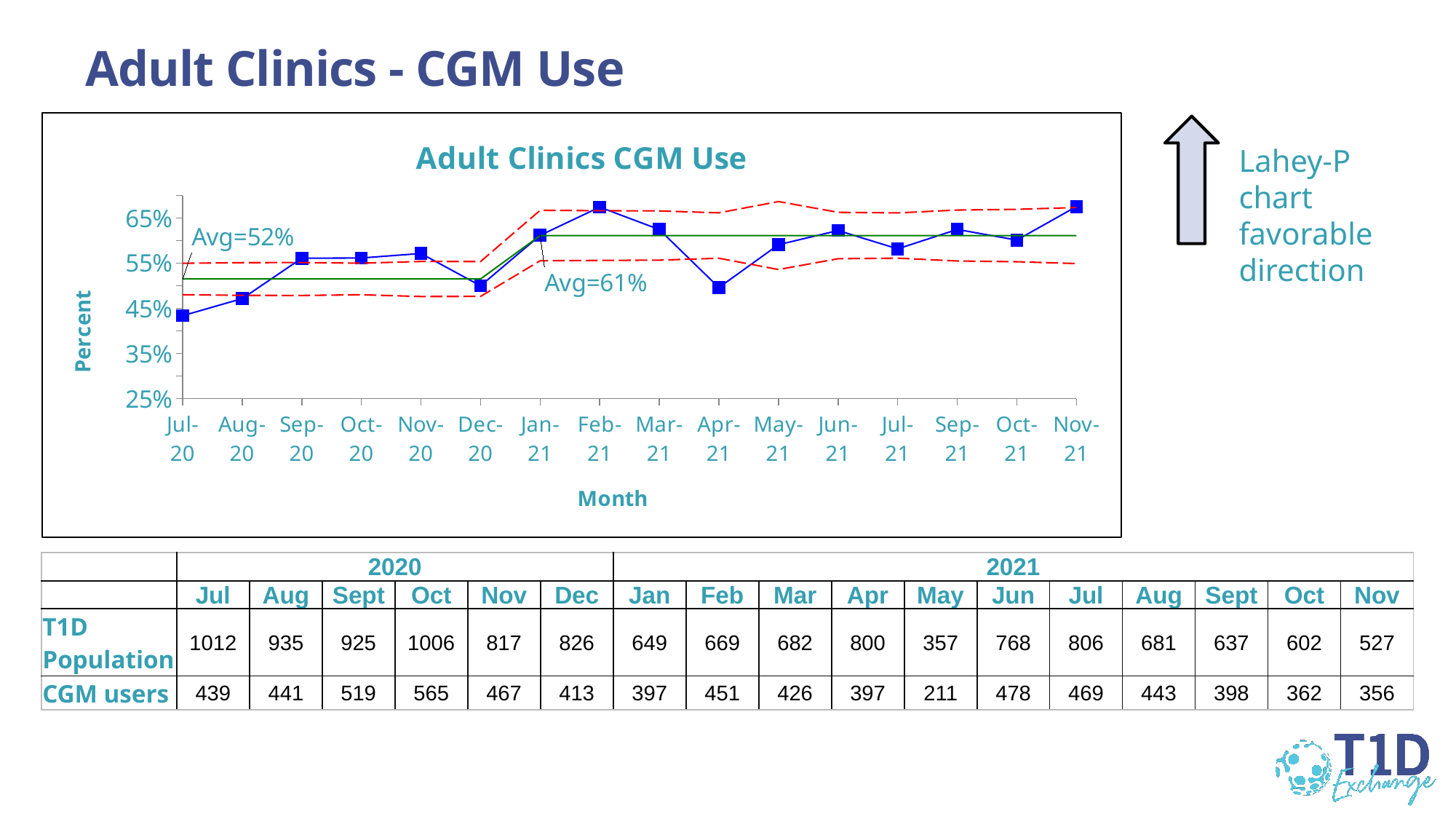
What is the title of the chart? Adult Clinics CGM Use Which has the larger value, Feb-21 or Apr-21? Feb-21 Is the value for Feb-21 greater or less than 65%? greater Which month has the lowest CGM use value on the chart? Jul-20 Is the value for Dec-20 greater or less than 55%? less What is the label on the vertical axis of the chart? Percent Overall, does CGM use rise or fall from Jul-20 to Nov-21? rise Is the value for Apr-21 greater or less than 55%? less What average value is annotated for the first period of the chart (Jul-20 to Dec-20)? Avg=52% What average value is annotated for the second period of the chart (Jan-21 onward)? Avg=61% How many months are plotted along the x axis of the chart? 16 What kind of chart is shown on the slide? line chart